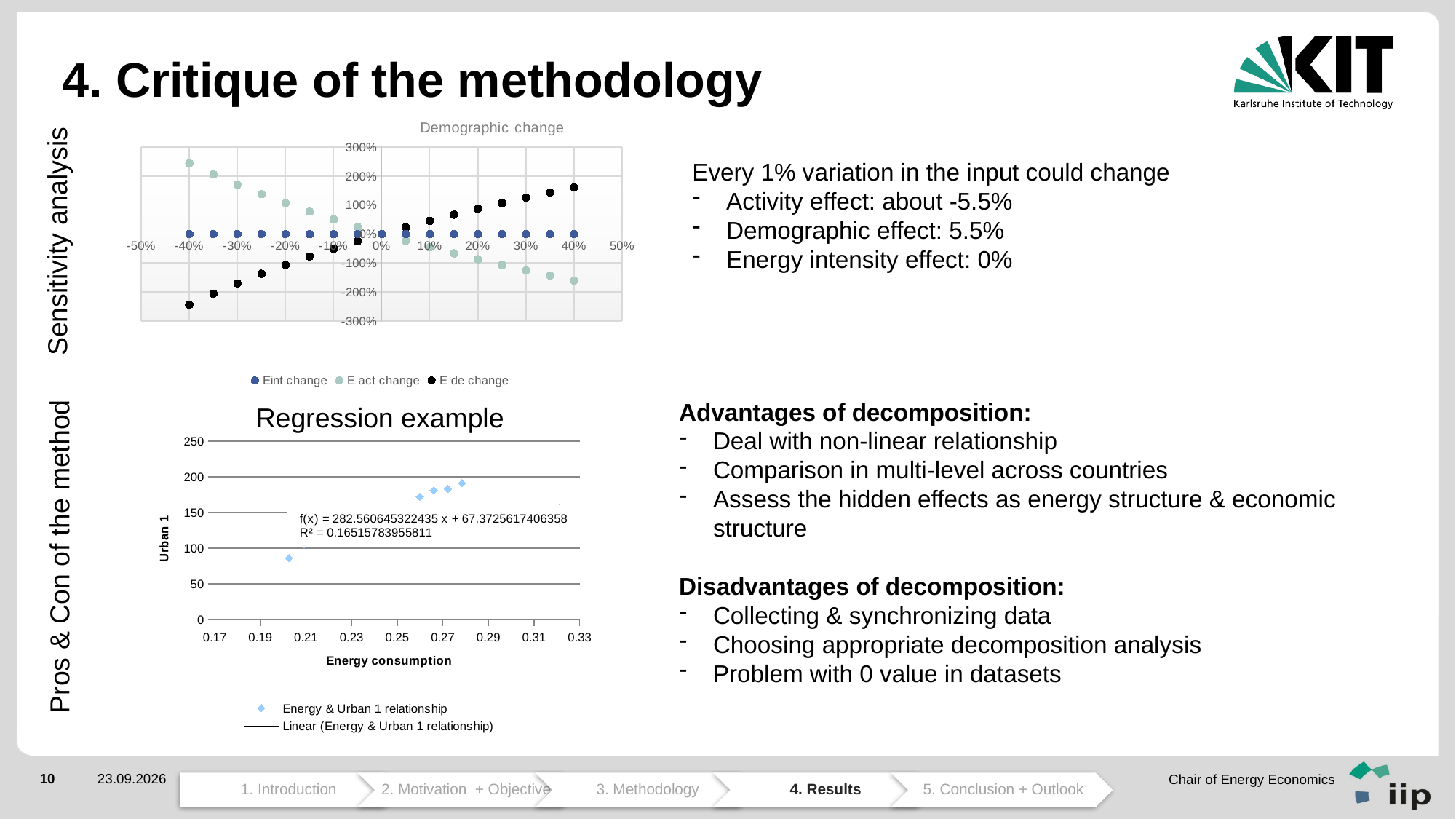
What kind of chart is the 'Regression example' chart? scatter chart In the 'Demographic change' chart, do the values of the 'E de change' series rise or fall as the x axis increases? rise In the 'Demographic change' chart, is the value of 'E act change' at -40% greater or less than 200%? greater In the 'Demographic change' chart, do the values of the 'E act change' series rise or fall as the x axis increases? fall In the 'Demographic change' chart, is the value of 'E de change' at 40% greater or less than 100%? greater In the 'Regression example' chart, is the Urban 1 value of the point near 0.28 energy consumption greater or less than 150? greater What kind of chart is the 'Demographic change' chart? scatter chart How many series does the legend of the 'Demographic change' chart list? 3 In the 'Demographic change' chart, which series is shown in black? E de change What is the R² value shown on the 'Regression example' chart? R² = 0.16515783955811 In the 'Demographic change' chart, at x = 40%, which series has the larger value, 'E de change' or 'E act change'? E de change